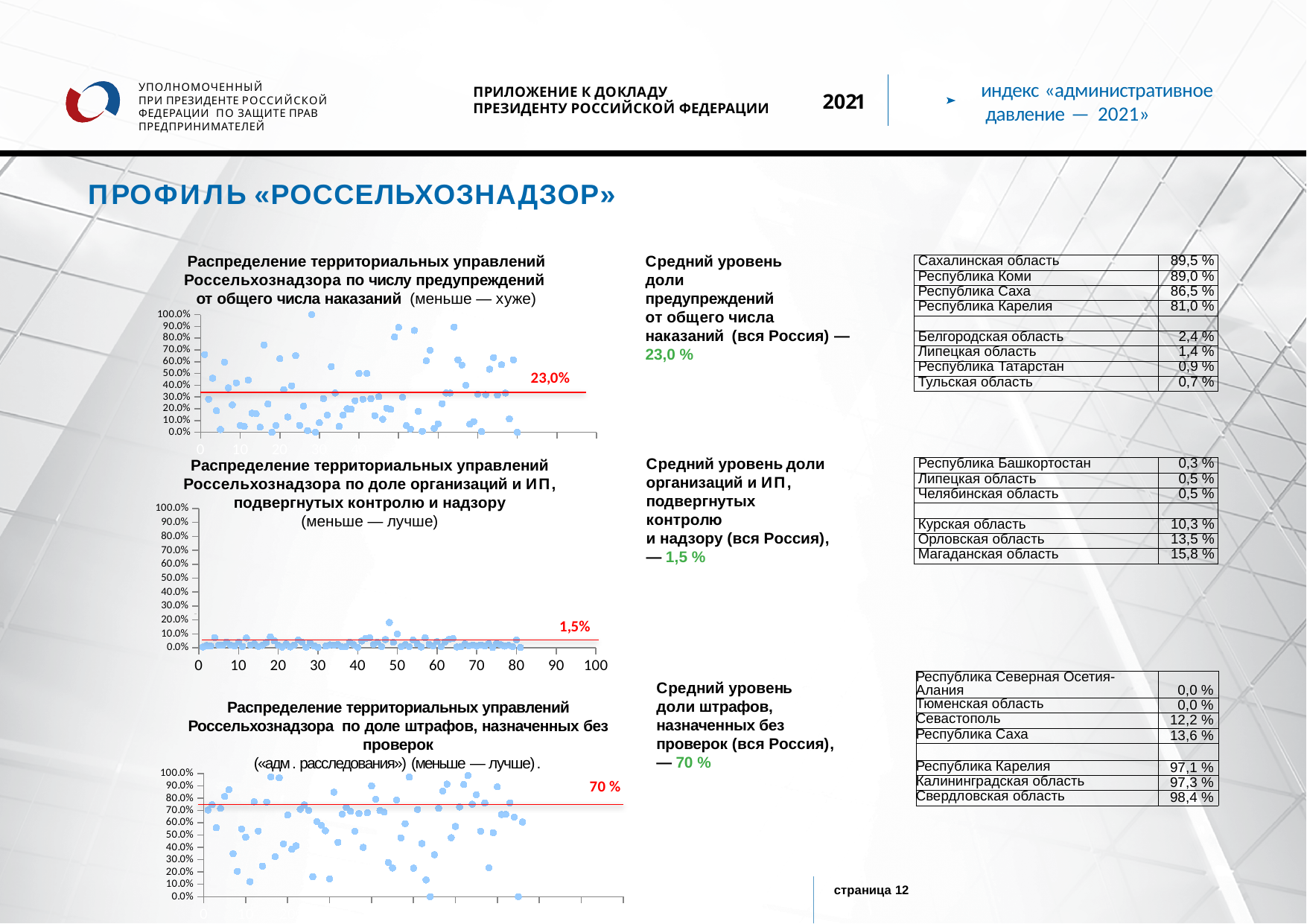
What is the maximum value shown on the y axis of the middle chart (по доле организаций и ИП)? 100.0% In the bottom chart (по доле штрафов, назначенных без проверок), what value is labelled on the red horizontal reference line? 70 % In the top chart (по числу предупреждений), is the reference line value greater or less than 20.0%? greater In the top chart (по числу предупреждений), what value is labelled on the red horizontal reference line? 23,0% Which reference line is higher: the one in the top chart (по числу предупреждений) or the one in the bottom chart (по доле штрафов)? the bottom chart (70 %) In the middle chart (по доле организаций и ИП, подвергнутых контролю и надзору), what value is labelled on the horizontal reference line? 1,5% In the middle chart (по доле организаций и ИП), is the reference line value greater or less than 10.0%? less What is the difference between the reference line value in the bottom chart (70 %) and the reference line value in the top chart (23,0%)? 47 percentage points What kind of chart is the top chart, 'Распределение территориальных управлений Россельхознадзора по числу предупреждений от общего числа наказаний'? scatter chart What is the maximum value shown on the x axis of the middle chart (по доле организаций и ИП)? 100 How many charts are shown on the slide? 3 In the bottom chart (по доле штрафов), is the reference line value greater or less than 60.0%? greater